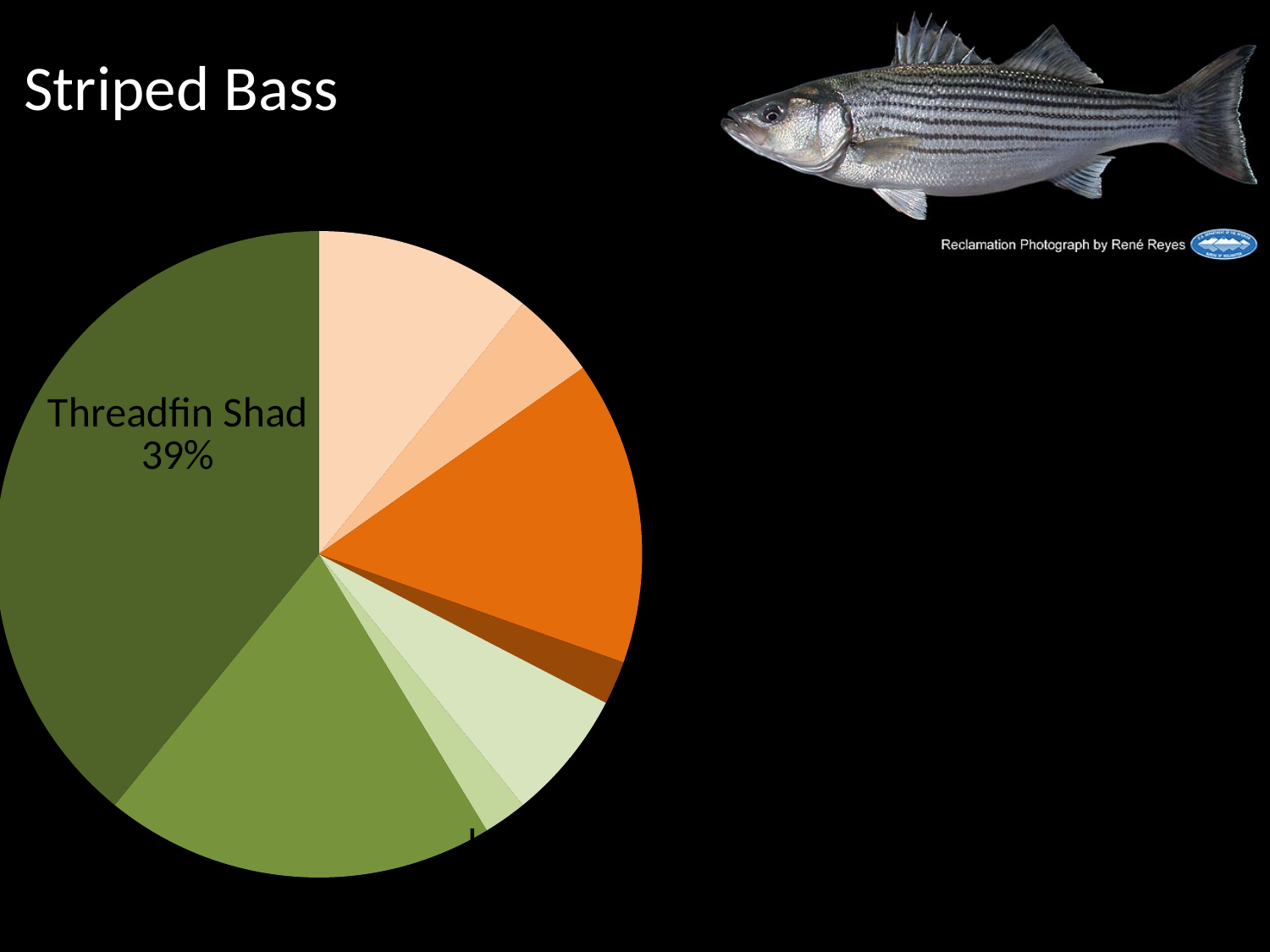
Which slice of the pie chart is labeled with a percentage? Threadfin Shad What percentage of the pie chart is Threadfin Shad? 39% Which labeled category has the largest slice in the pie chart? Threadfin Shad How many slices does the pie chart have? 8 What kind of chart is shown on the slide? pie chart What share of the pie does the Threadfin Shad slice represent? 39% What is the title of the slide containing the pie chart? Striped Bass